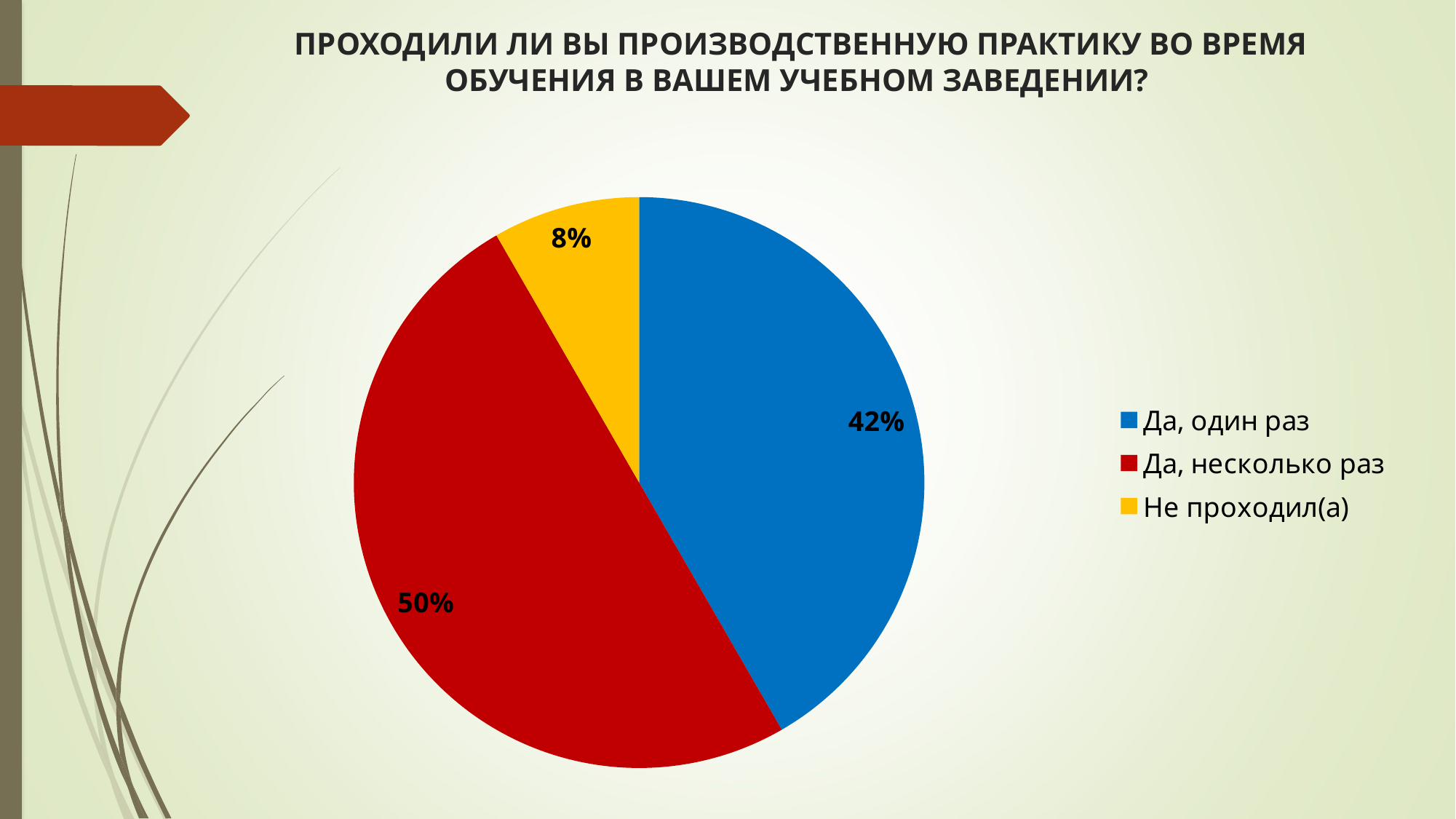
What share of the pie does "Не проходил(а)" represent? 8% What share of the pie does "Да, несколько раз" represent? 50% Which category has the smallest slice of the pie? Не проходил(а) Which category has the largest slice of the pie? Да, несколько раз What is the difference in percentage points between "Да, несколько раз" and "Да, один раз"? 8 How many entries does the legend list? 3 What colour is the slice for "Не проходил(а)"? yellow What is the difference in percentage points between "Да, один раз" and "Не проходил(а)"? 34 Which is larger: the slice for "Да, один раз" or the slice for "Не проходил(а)"? Да, один раз How many slices does the pie chart have? 3 What share of the pie does "Да, один раз" represent? 42% What kind of chart is shown on the slide? pie chart